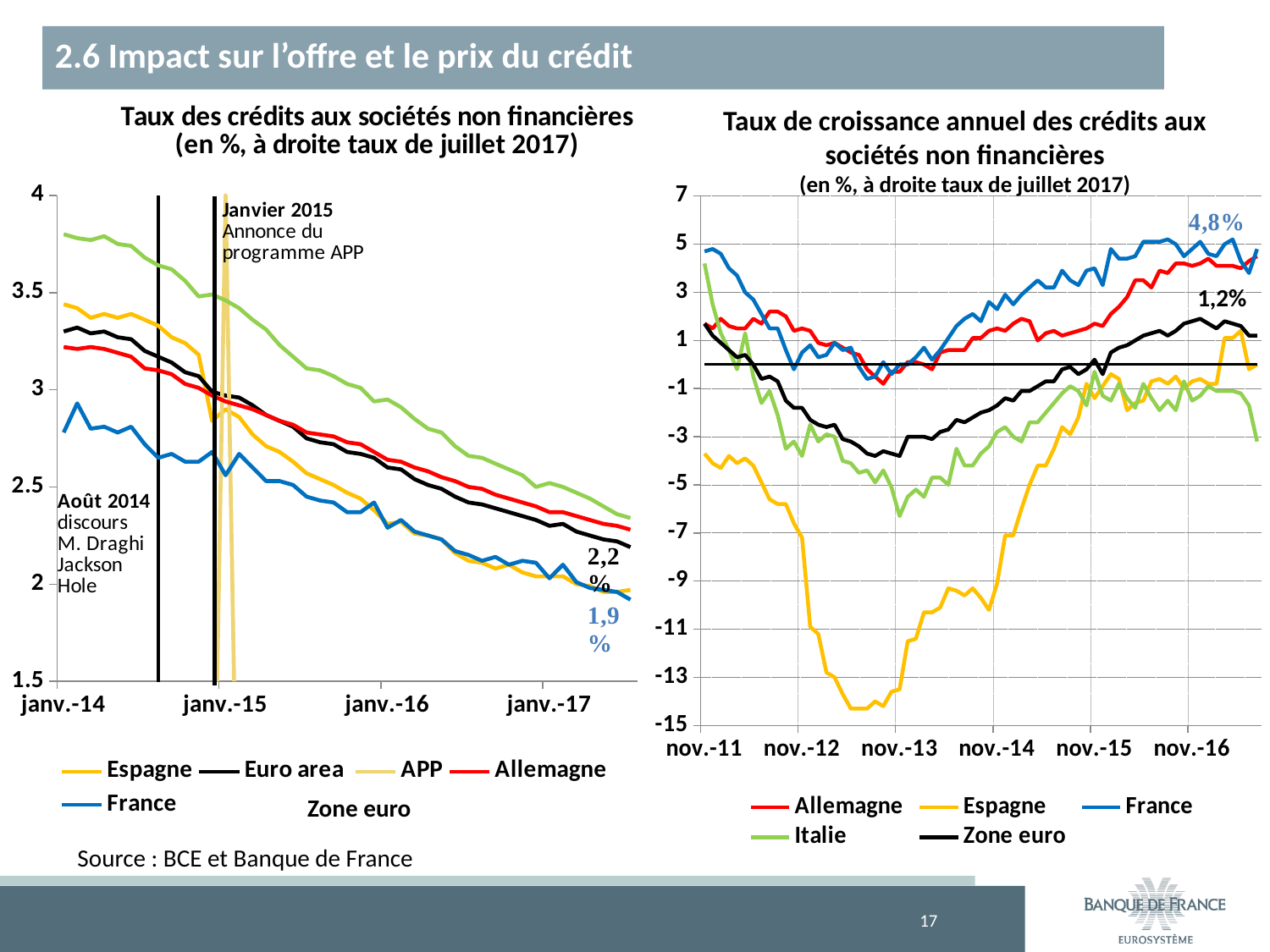
In the right chart, 'Taux de croissance annuel des crédits aux sociétés non financières', what is the July 2017 value labelled for France? 4,8% In the left chart, 'Taux des crédits aux sociétés non financières', what is the July 2017 value labelled for France? 1,9 % In the left chart, 'Taux des crédits aux sociétés non financières', does the Euro area line rise or fall from janv.-14 to 2017? fall How many series does the legend of the right chart, 'Taux de croissance annuel des crédits aux sociétés non financières', list? 5 How many series does the legend of the left chart, 'Taux des crédits aux sociétés non financières', list? 5 In the right chart, 'Taux de croissance annuel des crédits aux sociétés non financières', which series reaches the lowest value? Espagne What kind of chart is the left chart, 'Taux des crédits aux sociétés non financières'? line chart In the left chart, 'Taux des crédits aux sociétés non financières', what is the difference between the July 2017 values for the Euro area and France? 0,3 In the right chart, 'Taux de croissance annuel des crédits aux sociétés non financières', is the lowest value for Espagne greater or less than -13? less In the right chart, 'Taux de croissance annuel des crédits aux sociétés non financières', what is the July 2017 value labelled for Zone euro? 1,2% In the right chart, 'Taux de croissance annuel des crédits aux sociétés non financières', by how many percentage points does the July 2017 value for France exceed that of Zone euro? 3,6 In the left chart, 'Taux des crédits aux sociétés non financières', what is the July 2017 value labelled for the Euro area? 2,2 %